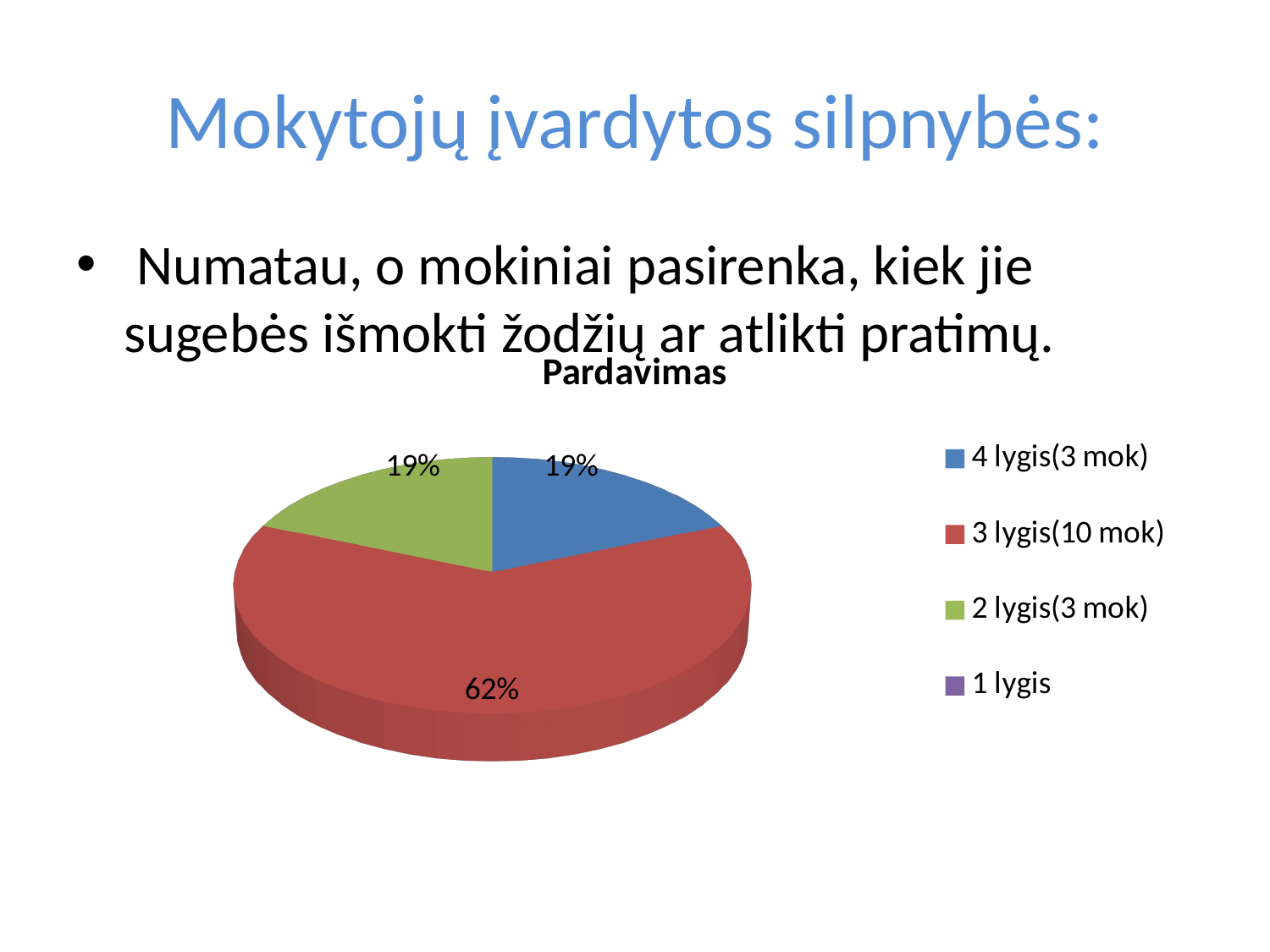
What share of the pie does the 3 lygis(10 mok) slice have? 62% What share of the pie does the 4 lygis(3 mok) slice have? 19% What share of the pie does the 2 lygis(3 mok) slice have? 19% What kind of chart is shown on the slide? pie chart What is the difference between the share for 3 lygis(10 mok) and the share for 4 lygis(3 mok)? 43% Which is larger, the share for 3 lygis(10 mok) or the share for 2 lygis(3 mok)? 3 lygis(10 mok) What is the title of the chart? Pardavimas Is the share for 3 lygis(10 mok) greater or less than 50%? greater Which category has the largest slice of the pie? 3 lygis(10 mok) Which colour represents 3 lygis(10 mok) in the chart? red How many entries does the legend list? 4